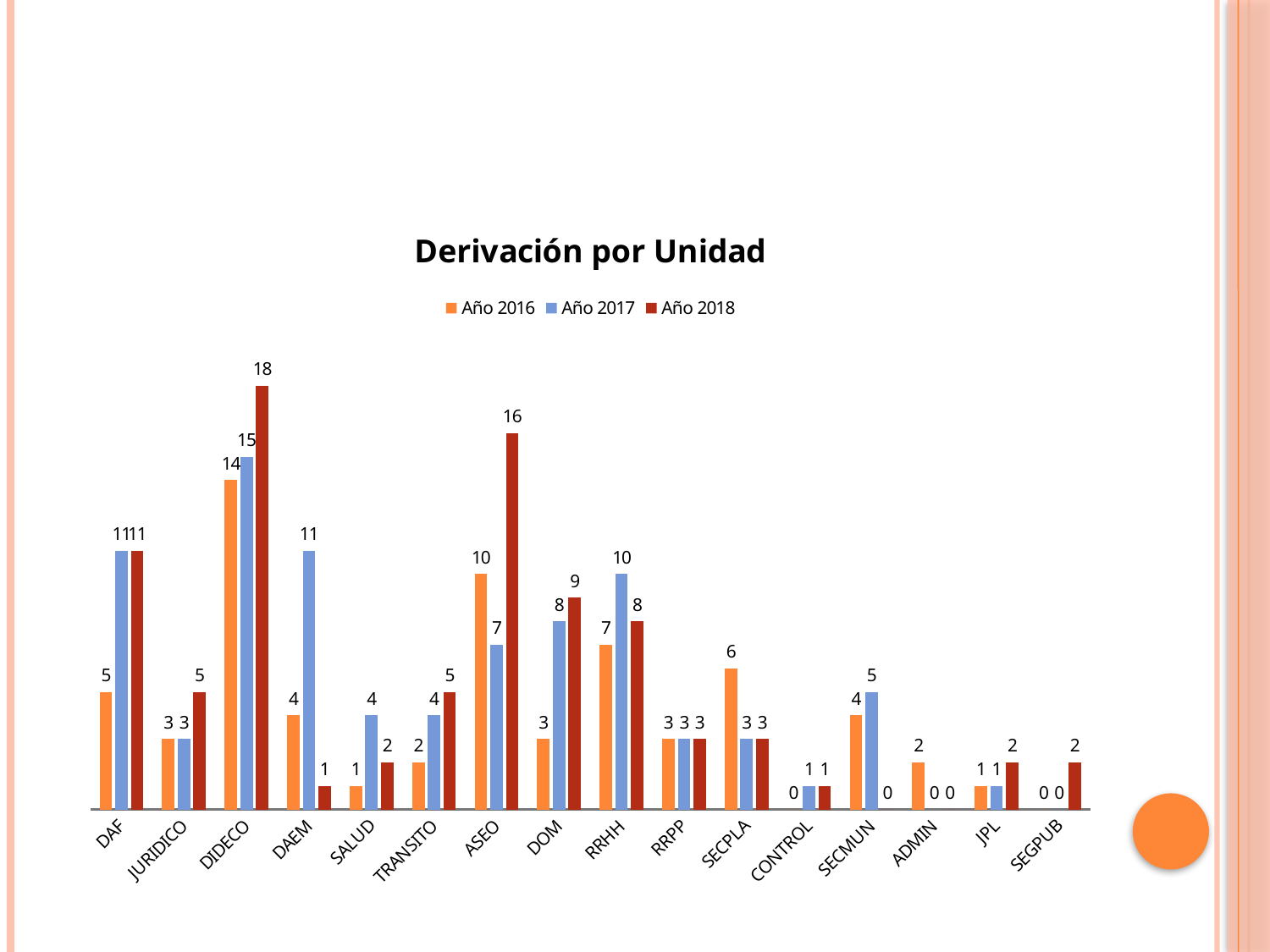
How many units are shown on the x axis? 16 Which unit has the highest value in Año 2016? DIDECO What is the difference between the Año 2018 and Año 2016 values for ASEO? 6 What is the value for DAEM in Año 2017? 11 What is the total of the three years' values for DOM? 20 What kind of chart is shown? Bar chart What is the value for ASEO in Año 2016? 10 Which is larger for RRHH: the Año 2017 value or the Año 2018 value? Año 2017 What is the value for DIDECO in Año 2018? 18 How many series does the legend list? 3 What is the title of the chart? Derivación por Unidad Which unit has the highest value in Año 2018? DIDECO